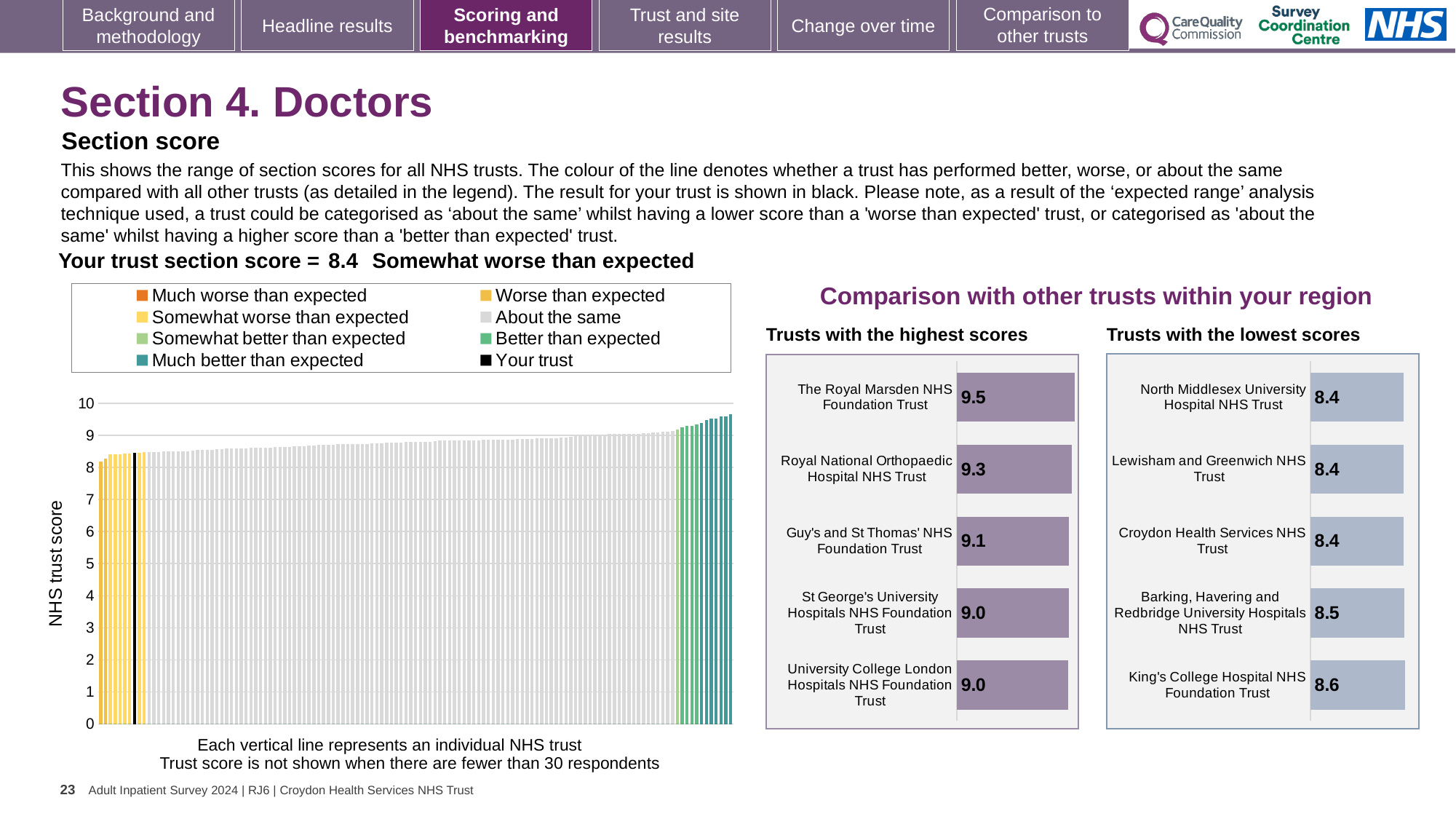
In the left-hand NHS trust score chart, do the values rise or fall from left to right along the x axis? Rise In the 'Trusts with the highest scores' chart, which trust has the highest score? The Royal Marsden NHS Foundation Trust How many entries does the legend of the left-hand NHS trust score chart list? 8 What kind of chart is the large chart on the left showing NHS trust scores? Bar chart In the 'Trusts with the highest scores' chart, what is the difference between the scores of The Royal Marsden NHS Foundation Trust and Guy's and St Thomas' NHS Foundation Trust? 0.4 In the left-hand NHS trust score chart, what is the section score for your trust (shown in black)? 8.4 In the 'Trusts with the highest scores' chart, what is the score for The Royal Marsden NHS Foundation Trust? 9.5 How many trusts are listed in the 'Trusts with the highest scores' chart? 5 In the 'Trusts with the lowest scores' chart, what is the score for Barking, Havering and Redbridge University Hospitals NHS Trust? 8.5 In the 'Trusts with the highest scores' chart, which has the larger score: Royal National Orthopaedic Hospital NHS Trust or Guy's and St Thomas' NHS Foundation Trust? Royal National Orthopaedic Hospital NHS Trust In the 'Trusts with the lowest scores' chart, what is the difference between the scores of King's College Hospital NHS Foundation Trust and Croydon Health Services NHS Trust? 0.2 In the 'Trusts with the lowest scores' chart, which trust has the highest score? King's College Hospital NHS Foundation Trust